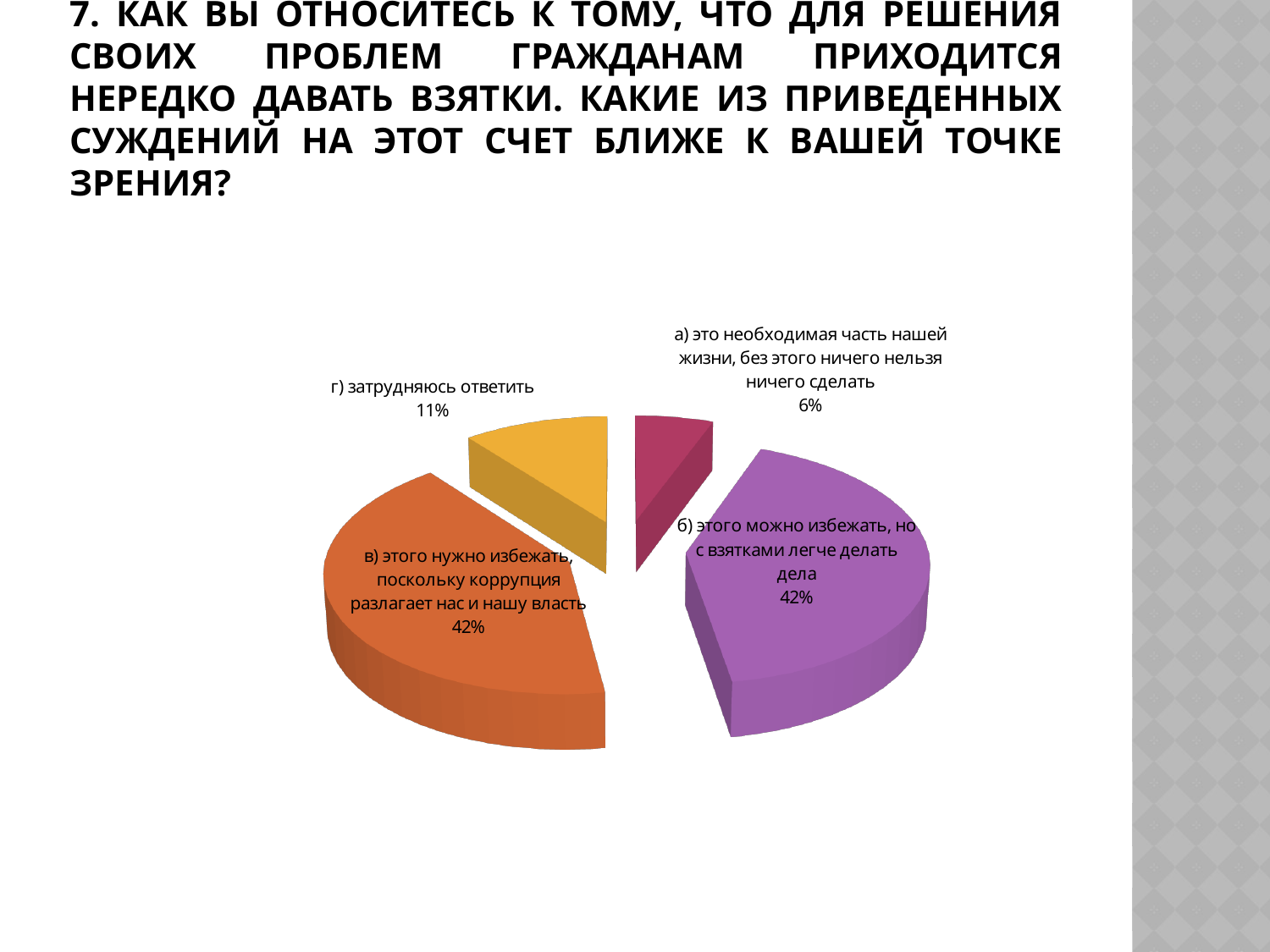
What colour is the slice for "г) затрудняюсь ответить"? yellow What percentage is shown for "б) этого можно избежать, но с взятками легче делать дела"? 42% Which answer option has the smallest share of the pie? а) это необходимая часть нашей жизни, без этого ничего нельзя ничего сделать What is the difference in percentage points between "б) этого можно избежать, но с взятками легче делать дела" and "г) затрудняюсь ответить"? 31 What colour is the slice for "в) этого нужно избежать, поскольку коррупция разлагает нас и нашу власть"? orange How many slices does the pie chart have? 4 Which is larger: the share for "г) затрудняюсь ответить" or the share for "а) это необходимая часть нашей жизни"? г) затрудняюсь ответить What kind of chart is shown on the slide? pie chart What is the difference in percentage points between "г) затрудняюсь ответить" and "а) это необходимая часть нашей жизни"? 5 What percentage is shown for "г) затрудняюсь ответить"? 11% What percentage is shown for "в) этого нужно избежать, поскольку коррупция разлагает нас и нашу власть"? 42% What share of the pie is labelled "а) это необходимая часть нашей жизни, без этого ничего нельзя ничего сделать"? 6%